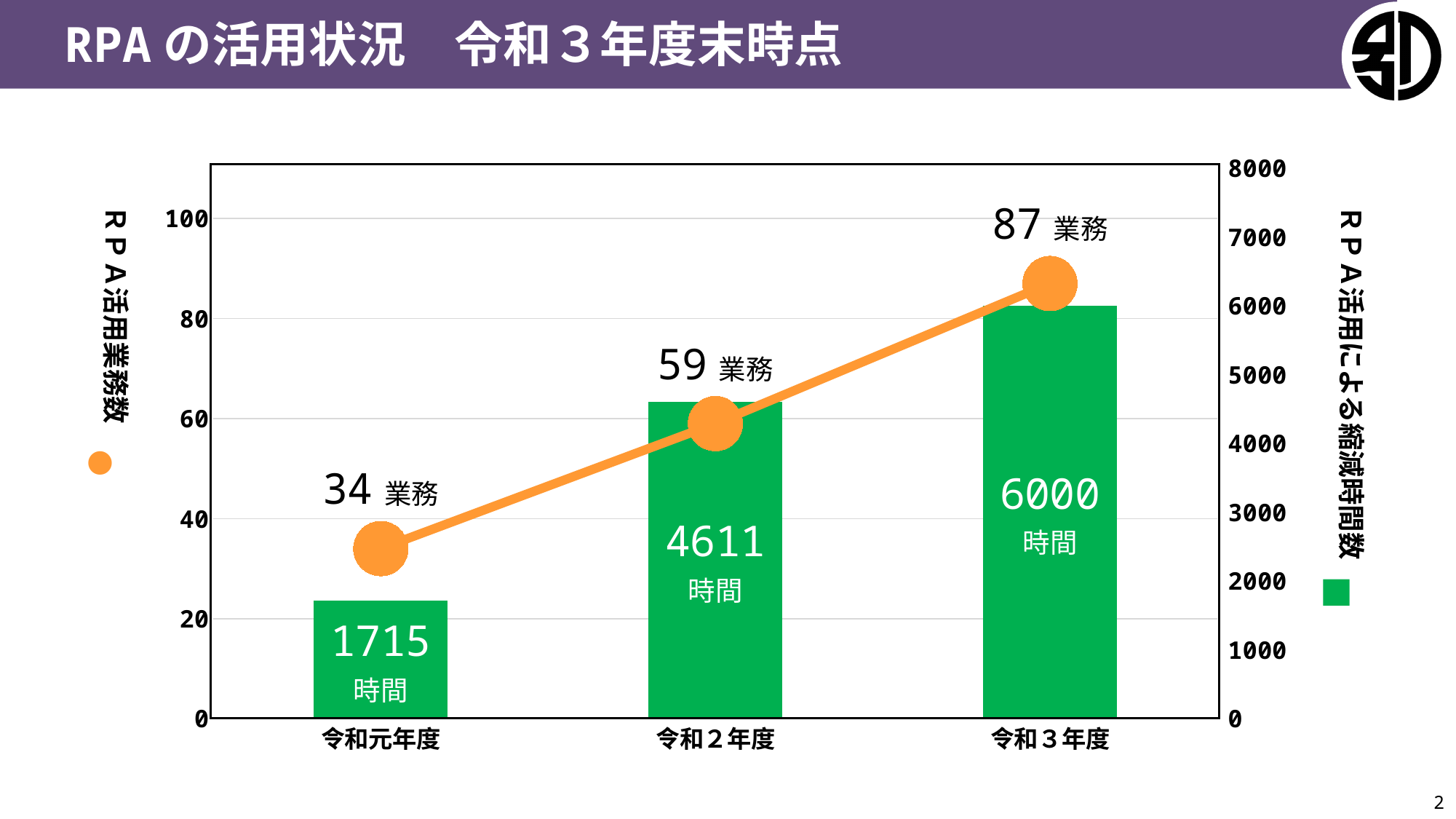
Which is larger, the RPA活用業務数 for 令和２年度 or for 令和３年度? 令和３年度 What is the RPA活用による縮減時間数 (reduced hours) value for 令和元年度? 1715 時間 How many RPA活用業務数 (tasks using RPA) are shown for 令和３年度? 87 業務 Do the RPA活用による縮減時間数 values rise or fall from 令和元年度 to 令和３年度? rise What is the difference in RPA活用業務数 between 令和２年度 and 令和元年度? 25 業務 What is the difference in RPA活用による縮減時間数 between 令和３年度 and 令和２年度? 1389 時間 How many RPA活用業務数 (tasks using RPA) are shown for 令和元年度? 34 業務 Which fiscal year has the lowest RPA活用業務数? 令和元年度 How many fiscal years are shown on the x axis? 3 What colour are the bars representing RPA活用による縮減時間数? green Which fiscal year has the highest RPA活用による縮減時間数? 令和３年度 What is the RPA活用による縮減時間数 (reduced hours) value for 令和２年度? 4611 時間